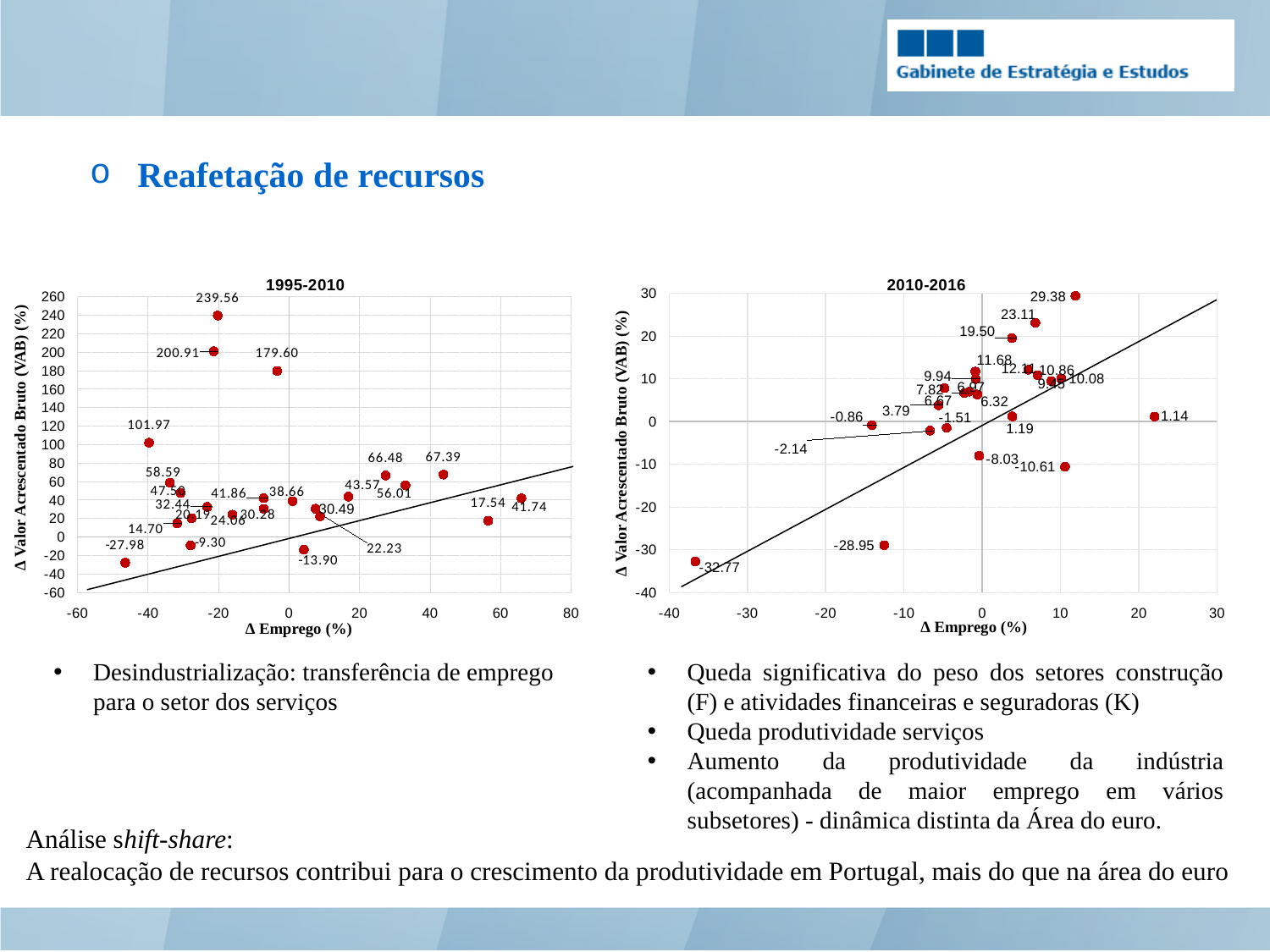
In the 1995-2010 chart, what is the highest labelled Δ VAB value? 239.56 What is the title of the chart on the left of the slide? 1995-2010 In the 2010-2016 chart, is the Δ Emprego value of the point labelled -32.77 greater or less than -30? less Which chart has the larger maximum labelled Δ VAB value, 1995-2010 or 2010-2016? 1995-2010 In the 1995-2010 chart, is the Δ Emprego value of the point labelled 17.54 greater or less than 40? greater In the 2010-2016 chart, what is the lowest labelled Δ VAB value? -32.77 In the 2010-2016 chart, what is the difference between the two highest labelled values, 29.38 and 23.11? 6.27 What kind of chart is the 1995-2010 chart? Scatter chart In the 1995-2010 chart, what is the lowest labelled Δ VAB value? -27.98 What is the x-axis label of the 2010-2016 chart? Δ Emprego (%) In the 1995-2010 chart, what is the difference between the two highest labelled values, 239.56 and 200.91? 38.65 In the 2010-2016 chart, what is the highest labelled Δ VAB value? 29.38